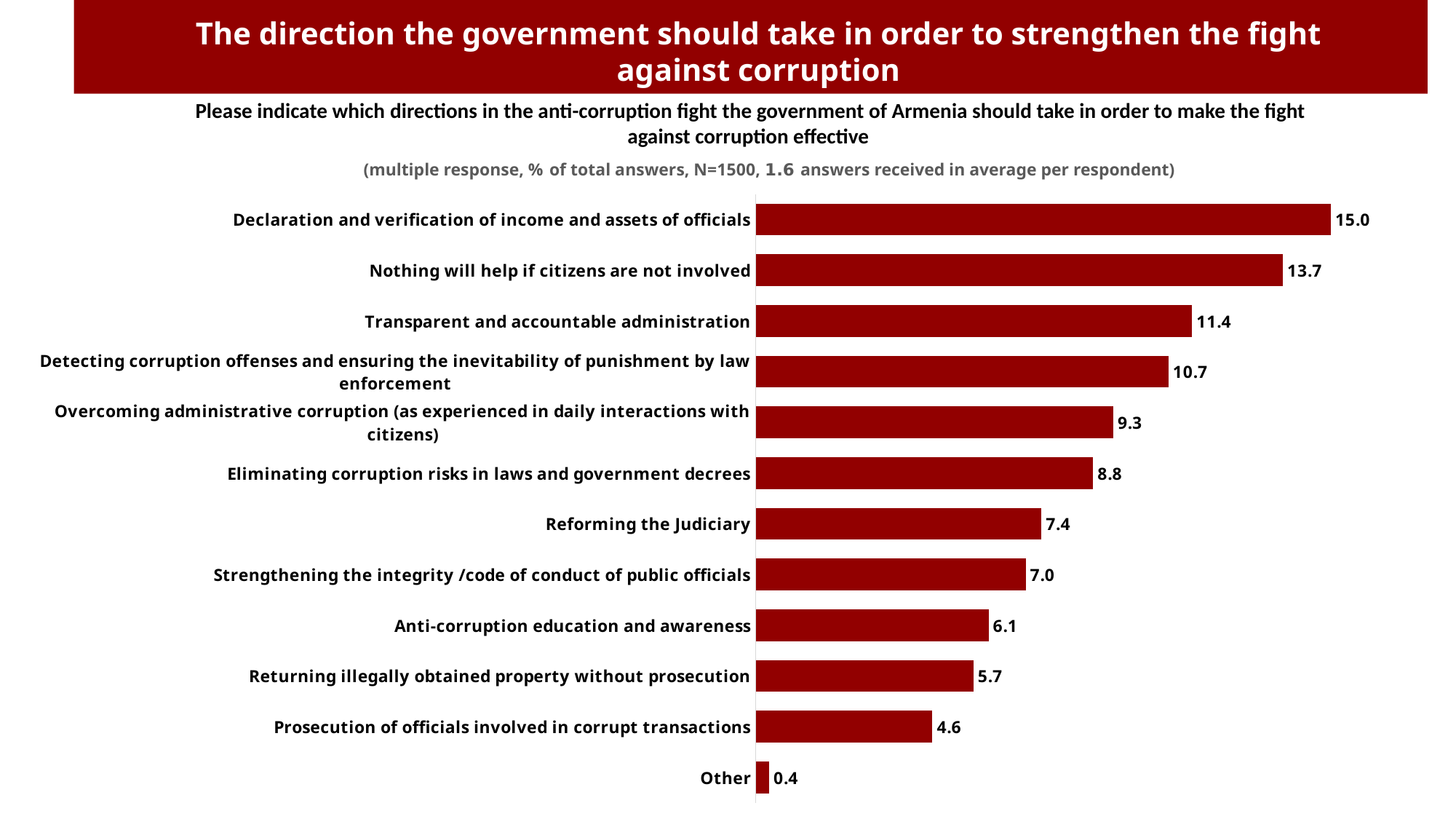
Which category has the highest value? Declaration and verification of income and assets of officials What is the value for "Overcoming administrative corruption (as experienced in daily interactions with citizens)"? 9.3 What is the difference between the values for "Returning illegally obtained property without prosecution" and "Prosecution of officials involved in corrupt transactions"? 1.1 What is the value for "Anti-corruption education and awareness"? 6.1 What is the value for "Reforming the Judiciary"? 7.4 Which category has the lowest value? Other What colour are the bars in the chart? Dark red What is the difference between the values for "Nothing will help if citizens are not involved" and "Transparent and accountable administration"? 2.3 What is the value for "Declaration and verification of income and assets of officials"? 15.0 What kind of chart is shown on the slide? Bar chart How many categories are shown in the chart? 12 Which is larger: the value for "Eliminating corruption risks in laws and government decrees" or the value for "Strengthening the integrity /code of conduct of public officials"? Eliminating corruption risks in laws and government decrees